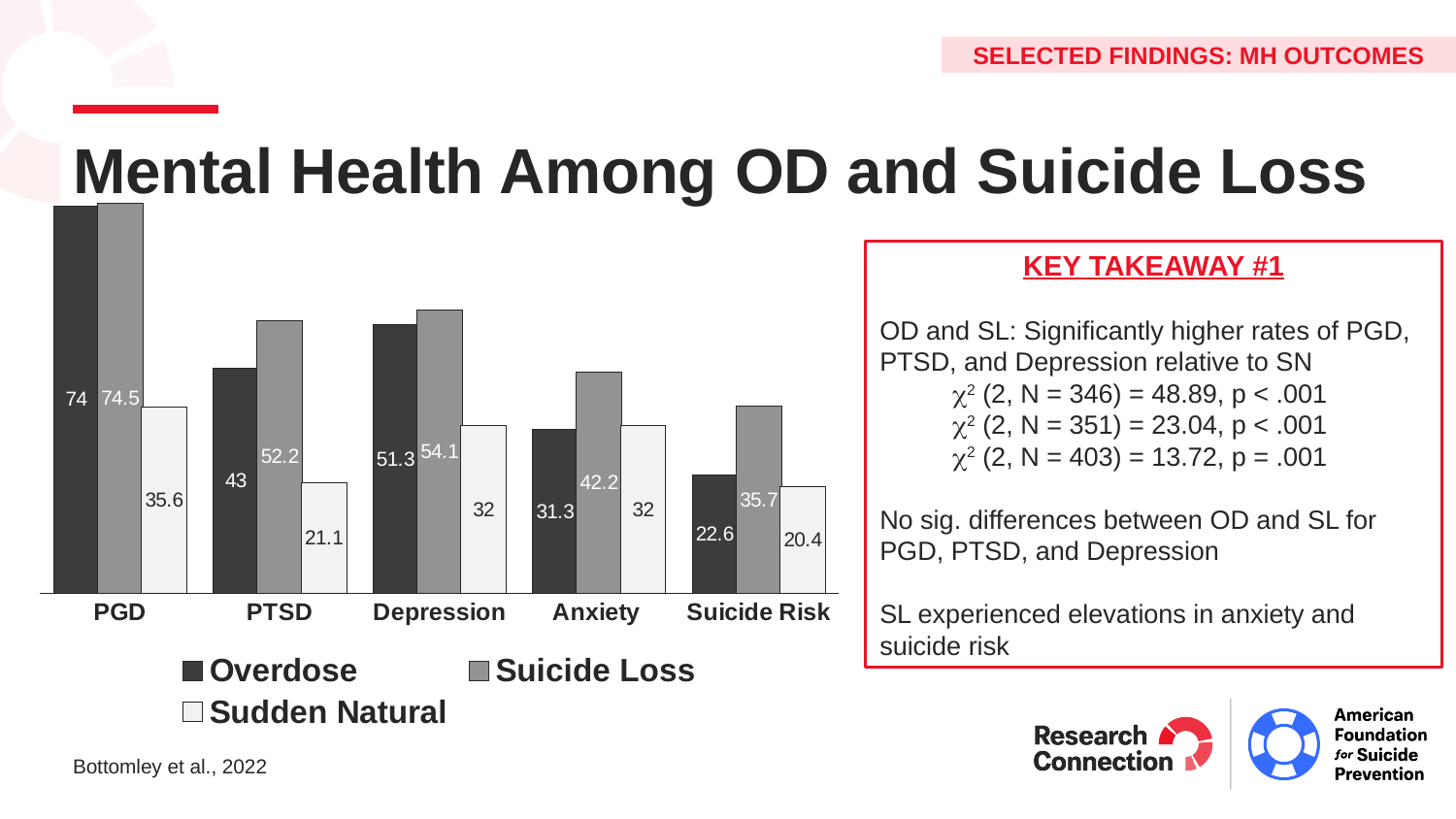
How many categories are shown on the x axis? 5 For Anxiety, which is larger: the Overdose value or the Sudden Natural value? Sudden Natural What is the Overdose value for PTSD? 43 What is the difference between the Overdose and Sudden Natural values for Depression? 19.3 What is the Sudden Natural value for PGD? 35.6 What kind of chart is shown on the slide? Bar chart What is the Suicide Loss value for Anxiety? 42.2 What is the difference between the Suicide Loss and Overdose values for PTSD? 9.2 Which category has the lowest Sudden Natural value? Suicide Risk What is the Suicide Loss value for Suicide Risk? 35.7 How many series does the legend list? 3 Which category has the highest Overdose value? PGD